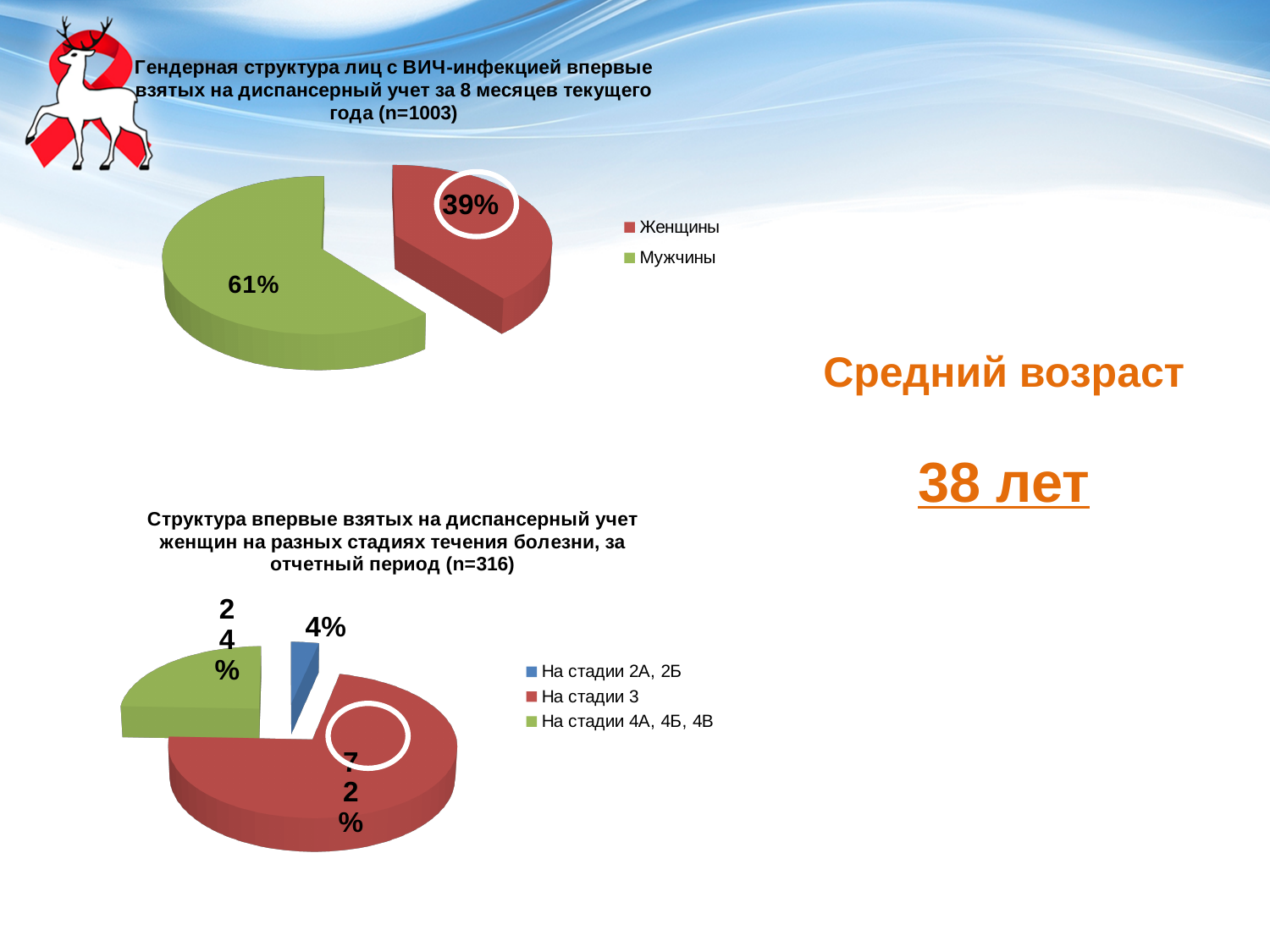
In the top pie chart (gender structure, n=1003), what share is labelled for Женщины? 39% In the top pie chart (gender structure), what is the difference in percentage points between Мужчины and Женщины? 22 How many categories does the legend of the bottom pie chart (stages of disease among women) list? 3 In the bottom pie chart (stages of disease among women), which category has the smallest share? На стадии 2А, 2Б In the top pie chart (gender structure, n=1003), what share is labelled for Мужчины? 61% In the top pie chart (gender structure), what colour is the slice for Женщины? Red How many legend entries does the top pie chart (gender structure) list? 2 In the top pie chart (gender structure), which category has the larger share? Мужчины In the bottom pie chart (stages of disease among women, n=316), what share is labelled for На стадии 4А, 4Б, 4В? 24% In the bottom pie chart (stages of disease among women, n=316), what share is labelled for На стадии 3? 72% What type of chart is the top chart on the slide? Pie chart In the bottom pie chart (stages of disease among women, n=316), what share is labelled for На стадии 2А, 2Б? 4%